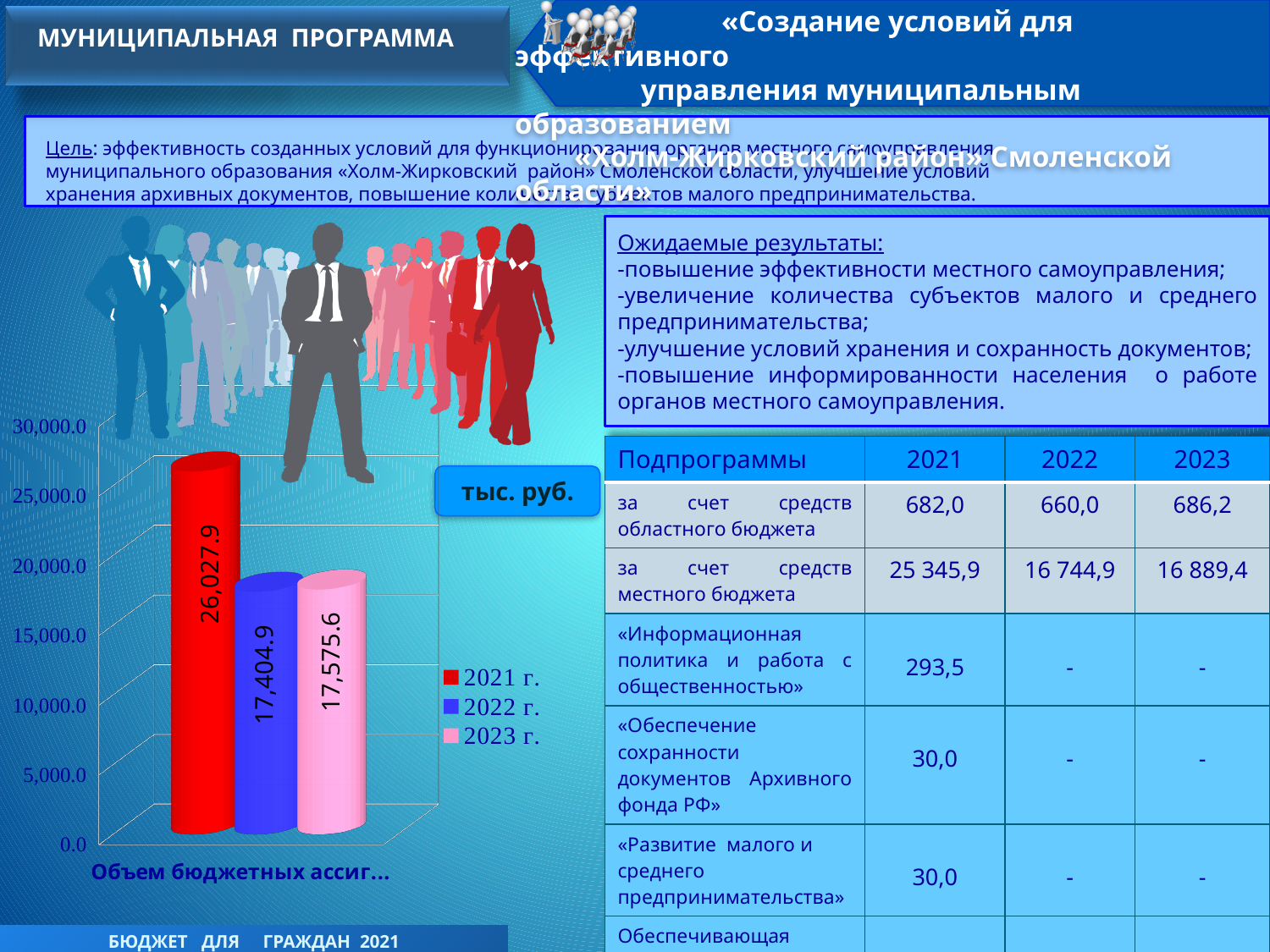
Which year has the highest value in the chart? 2021 г. What is the difference between the values for 2021 г. and 2022 г.? 8,623.0 Which is larger, the value for 2021 г. or the value for 2023 г.? 2021 г. Is the value for 2021 г. greater or less than 25,000.0? greater What is the value for 2023 г. in the chart? 17,575.6 Which year has the lowest value in the chart? 2022 г. How many series does the chart legend list? 3 What kind of chart is shown on the slide? bar chart What is the difference between the values for 2023 г. and 2022 г.? 170.7 What is the value for 2021 г. in the chart? 26,027.9 What is the value for 2022 г. in the chart? 17,404.9 What unit label is shown in the box next to the chart? тыс. руб.